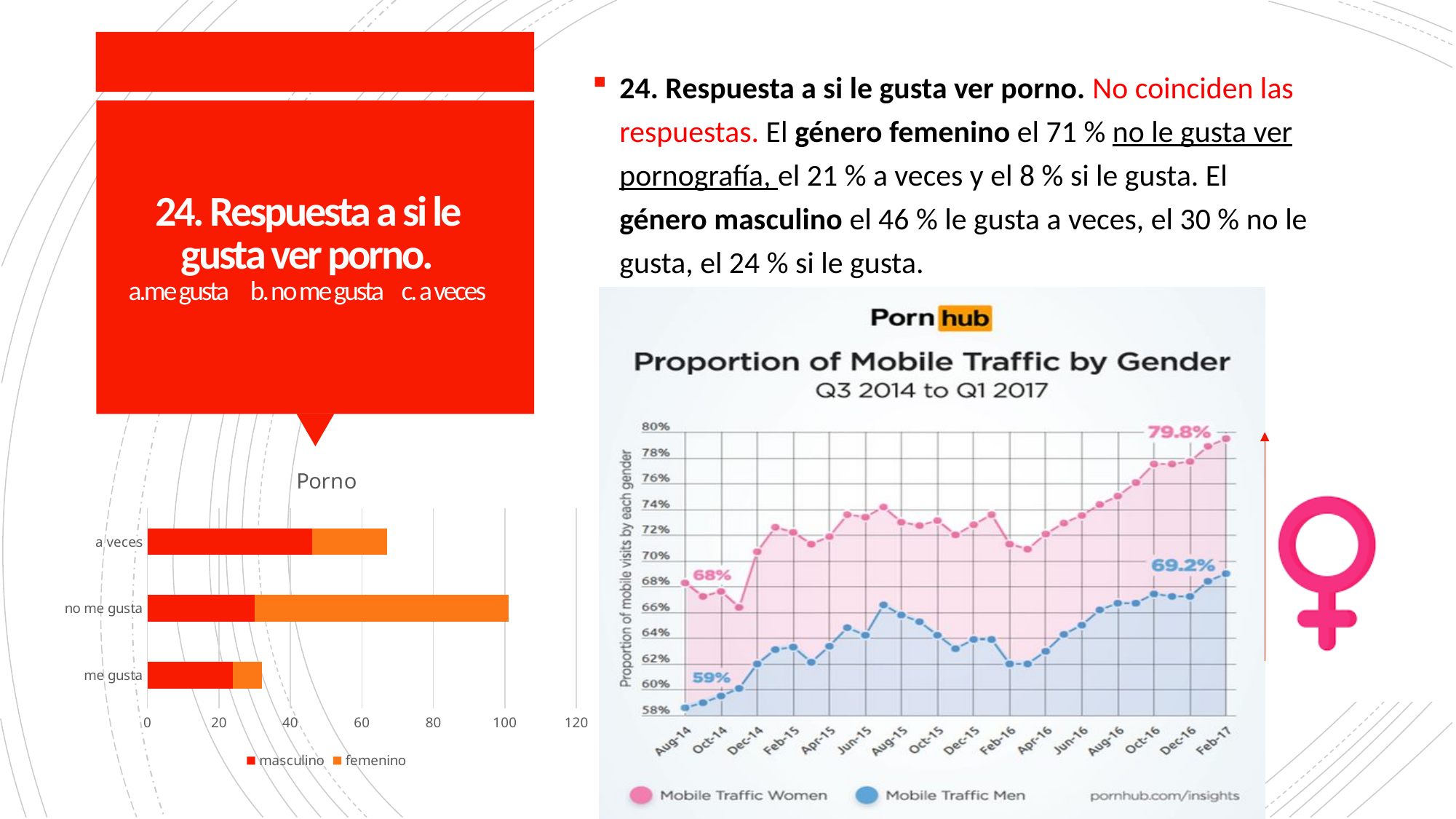
In the 'Porno' bar chart, which category has the shortest total bar? me gusta What type of chart is the 'Porno' chart on the left of the slide? bar chart In the 'Porno' bar chart, which category has the longest total bar? no me gusta How many series does the legend of the 'Porno' bar chart list? 2 In the 'Proportion of Mobile Traffic by Gender' chart, do the values for Mobile Traffic Men generally rise or fall from Aug-14 to Feb-17? rise In the 'Porno' bar chart, is the total bar for 'me gusta' greater or less than 40? less In the 'Proportion of Mobile Traffic by Gender' chart, what is the value for Mobile Traffic Women at Feb-17? 79.8% In the 'Porno' bar chart, is the total bar for 'no me gusta' greater or less than 80? greater How many categories are shown on the 'Porno' bar chart? 3 In the 'Porno' bar chart, which series has the larger segment for 'a veces', masculino or femenino? masculino What type of chart is the 'Proportion of Mobile Traffic by Gender' chart? line chart In the 'Proportion of Mobile Traffic by Gender' chart, what is the value for Mobile Traffic Men at Aug-14? 59%